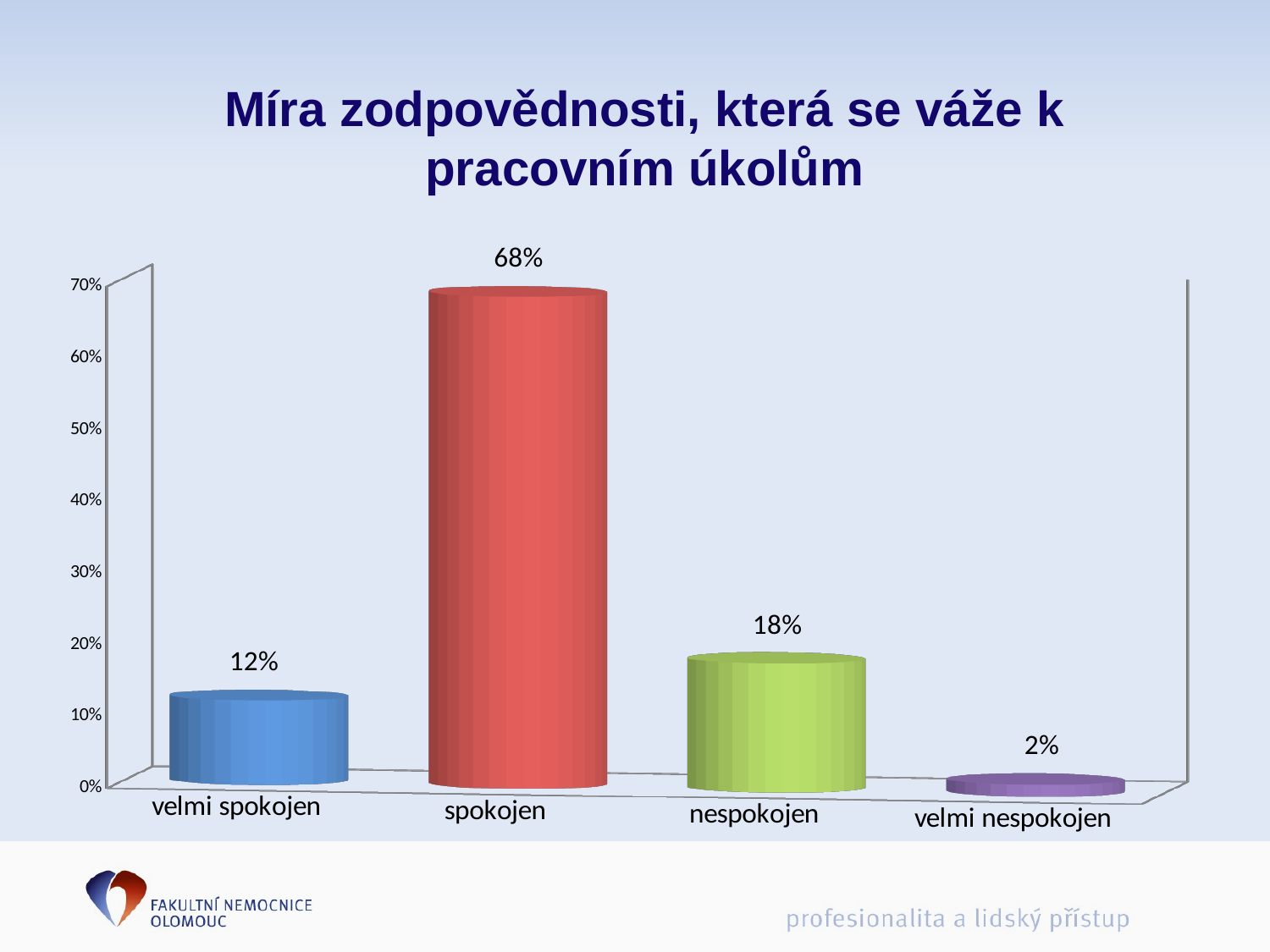
What is the value for "velmi nespokojen"? 2% Which category has the lowest value? velmi nespokojen What is the value for "spokojen"? 68% Which is larger, the value for "velmi spokojen" or the value for "nespokojen"? nespokojen What kind of chart is shown on the slide? bar chart What is the title of the slide? Míra zodpovědnosti, která se váže k pracovním úkolům What is the difference between the values for "spokojen" and "nespokojen"? 50% What is the value for "nespokojen"? 18% Which category has the highest value? spokojen What is the value for "velmi spokojen"? 12% How many categories are shown on the x axis? 4 What is the difference between the values for "nespokojen" and "velmi spokojen"? 6%